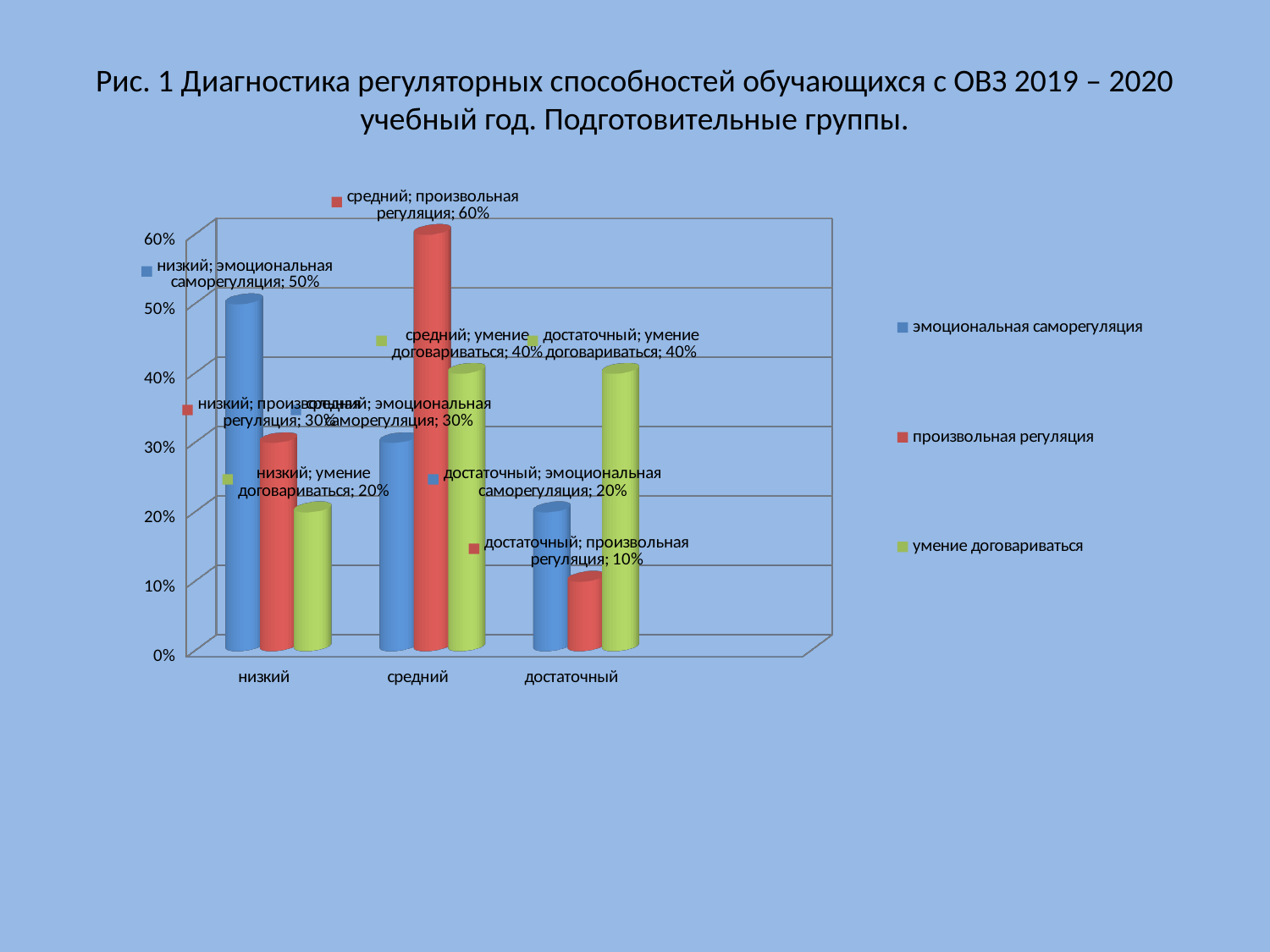
How many series does the legend list? 3 What is the value for произвольная регуляция in the достаточный category? 10% What is the value for эмоциональная саморегуляция in the низкий category? 50% Which category has the highest value for произвольная регуляция? средний Which category has the lowest value for эмоциональная саморегуляция? достаточный How many categories are shown on the x axis? 3 What is the value for умение договариваться in the достаточный category? 40% What is the value for произвольная регуляция in the средний category? 60% What kind of chart is shown on the slide? bar chart Which series is shown in red in the legend? произвольная регуляция What is the difference between произвольная регуляция in the средний category and in the достаточный category? 50% Which is larger: эмоциональная саморегуляция in the низкий category or умение договариваться in the низкий category? эмоциональная саморегуляция in the низкий category